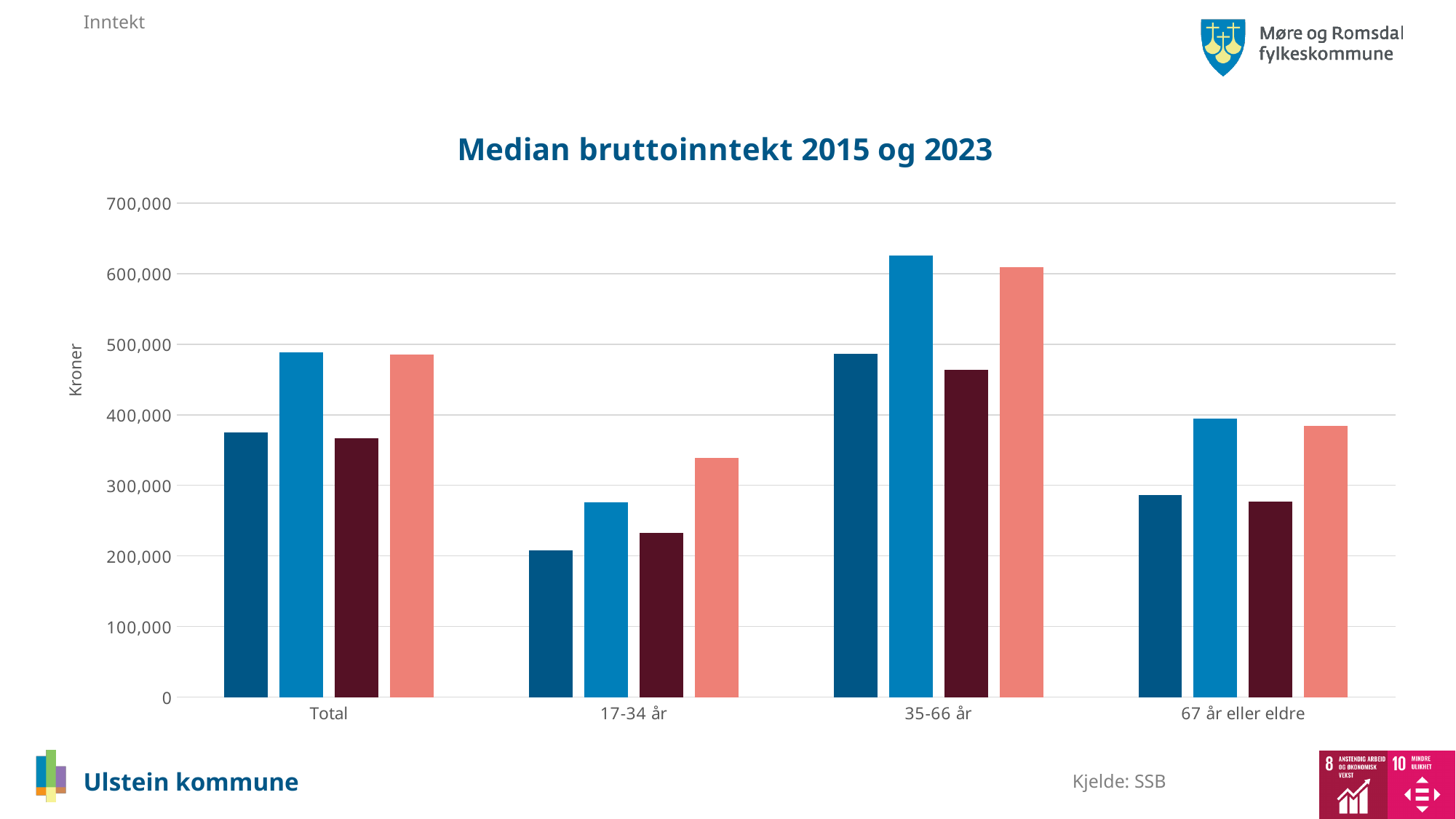
What kind of chart is shown on the slide? bar chart Is the value of the dark blue bar for Total greater or less than 300,000? greater How many categories are shown along the x axis of the chart? 4 Which category contains the shortest bar in the chart? 17-34 år Is the value of the salmon-coloured bar for 67 år eller eldre greater or less than 400,000? less Which category contains the tallest bar in the chart? 35-66 år What is the label on the vertical axis of the chart? Kroner How many bars are plotted for each category in the chart? 4 Is the value of the light blue bar for 35-66 år greater or less than 600,000? greater What is the title of the chart? Median bruttoinntekt 2015 og 2023 Which is larger: the dark blue bar for Total or the dark blue bar for 67 år eller eldre? Total